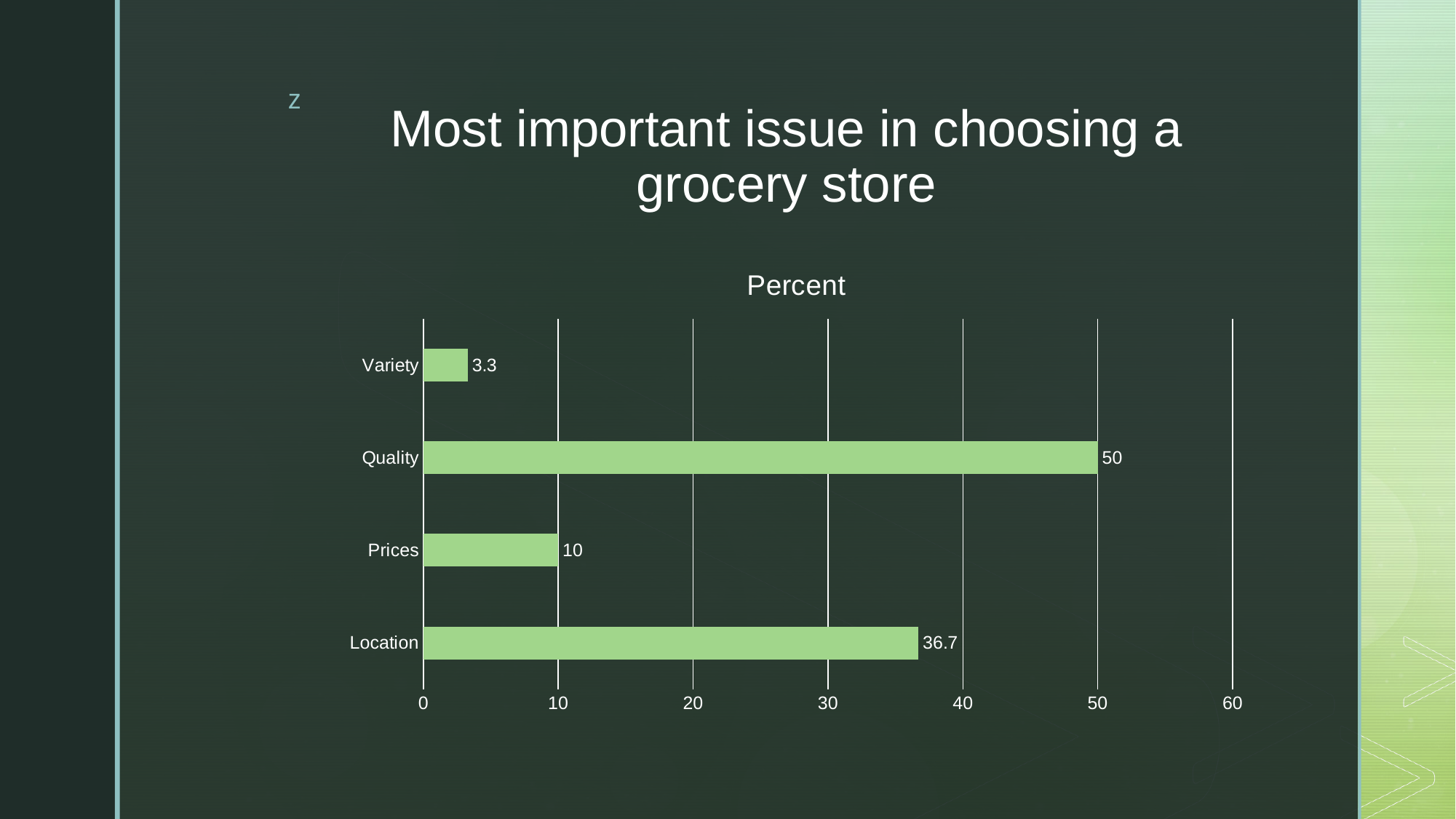
What is the value for Location? 36.7 What is the difference between the values for Prices and Variety? 6.7 Which category has the highest value? Quality Which is larger, the value for Location or the value for Prices? Location Which category has the lowest value? Variety What is the difference between the values for Quality and Location? 13.3 What kind of chart is shown on the slide? bar chart What is the value for Prices? 10 Is the value for Location greater or less than 40? less How many categories are shown in the chart? 4 What is the value for Quality? 50 What is the value for Variety? 3.3